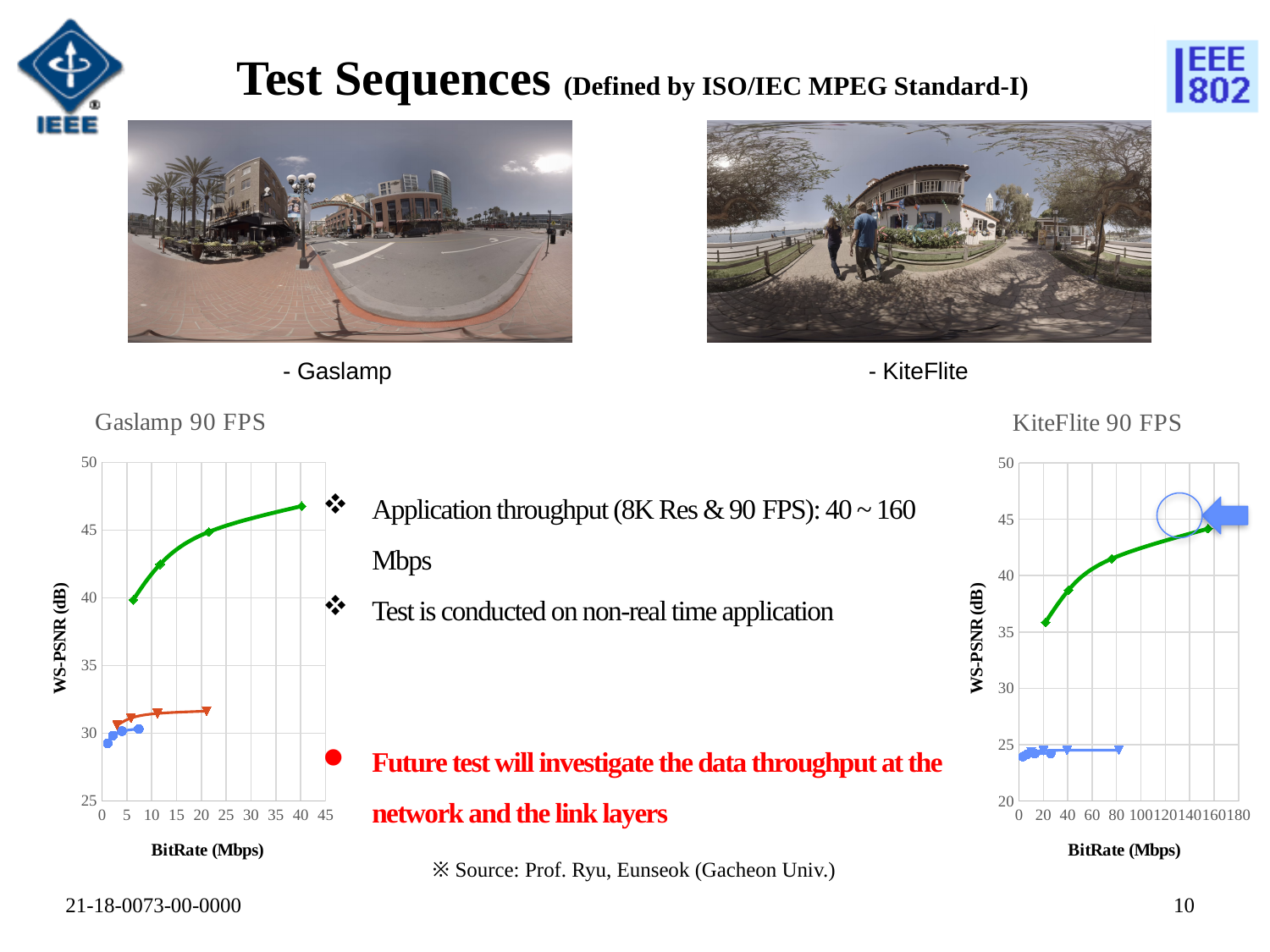
What kind of chart is the Gaslamp 90 FPS chart? line chart What is the y-axis title of the KiteFlite 90 FPS chart? WS-PSNR (dB) In the Gaslamp 90 FPS chart, which line has higher WS-PSNR values, the green line or the blue line? green line What is the x-axis title of the Gaslamp 90 FPS chart? BitRate (Mbps) In the Gaslamp 90 FPS chart, does the green line rise or fall as BitRate increases? rises In the Gaslamp 90 FPS chart, is the WS-PSNR of the orange line at 20 Mbps greater or less than 35? less In the KiteFlite 90 FPS chart, does the green line rise or fall as BitRate increases? rises In the KiteFlite 90 FPS chart, is the WS-PSNR of the blue line at 80 Mbps greater or less than 30? less In the Gaslamp 90 FPS chart, is the WS-PSNR of the green line at 40 Mbps greater or less than 45? greater What kind of chart is the KiteFlite 90 FPS chart? line chart